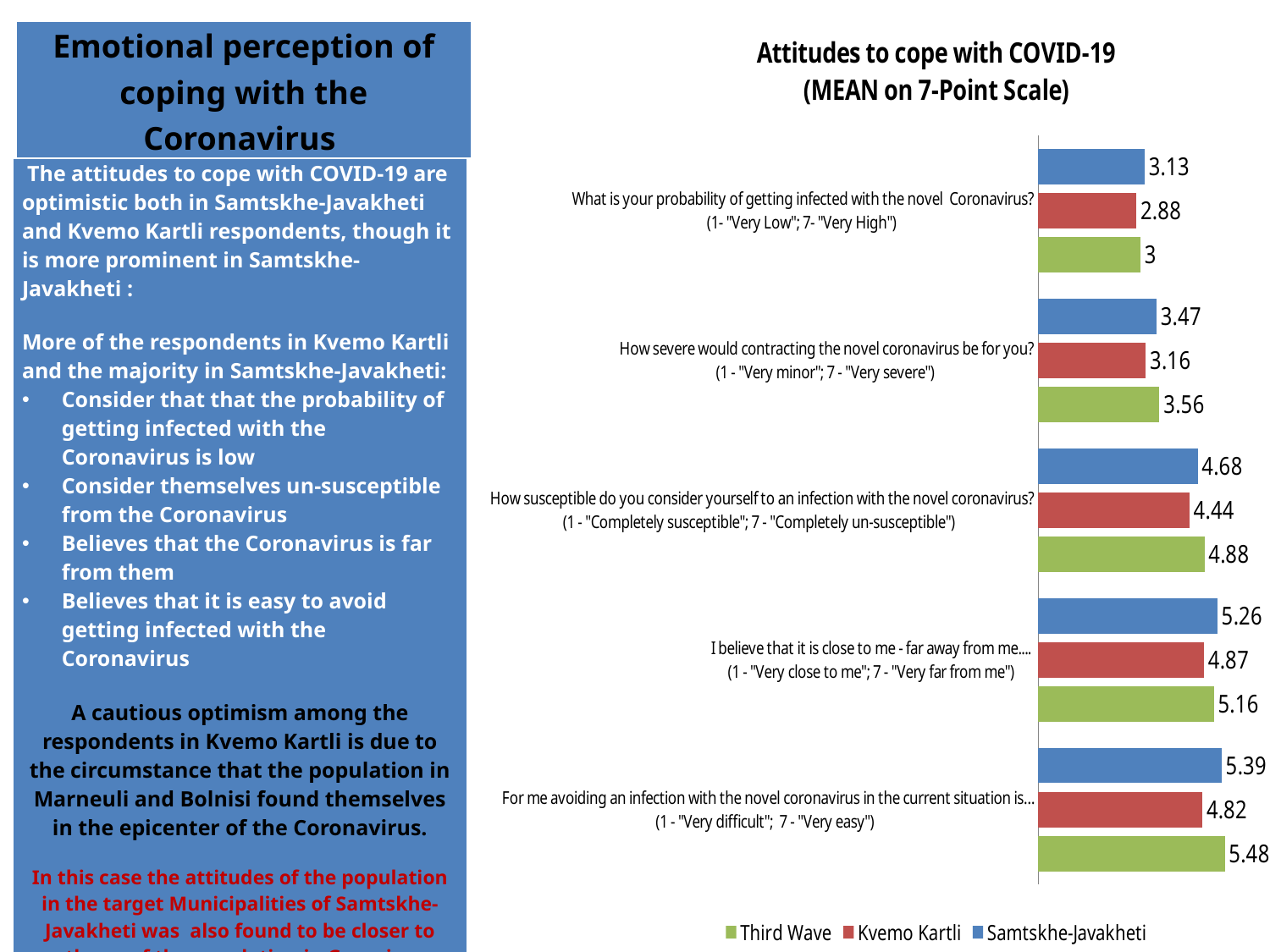
Which question has the lowest Kvemo Kartli value? What is your probability of getting infected with the novel Coronavirus? How many series does the legend list? 3 Which colour represents Kvemo Kartli in the chart? Red How many questions (categories) are shown on the chart? 5 What kind of chart is shown on the slide? Bar chart For "How severe would contracting the novel coronavirus be for you?", which is larger: the Third Wave value or the Samtskhe-Javakheti value? Third Wave Which question has the highest Third Wave value? For me avoiding an infection with the novel coronavirus in the current situation is... What is the Samtskhe-Javakheti value for "What is your probability of getting infected with the novel Coronavirus?"? 3.13 What is the Kvemo Kartli value for "How severe would contracting the novel coronavirus be for you?"? 3.16 What is the difference between the Samtskhe-Javakheti and Kvemo Kartli values for "I believe that it is close to me - far away from me...."? 0.39 What is the Kvemo Kartli value for "For me avoiding an infection with the novel coronavirus in the current situation is..."? 4.82 What is the Third Wave value for "How susceptible do you consider yourself to an infection with the novel coronavirus?"? 4.88